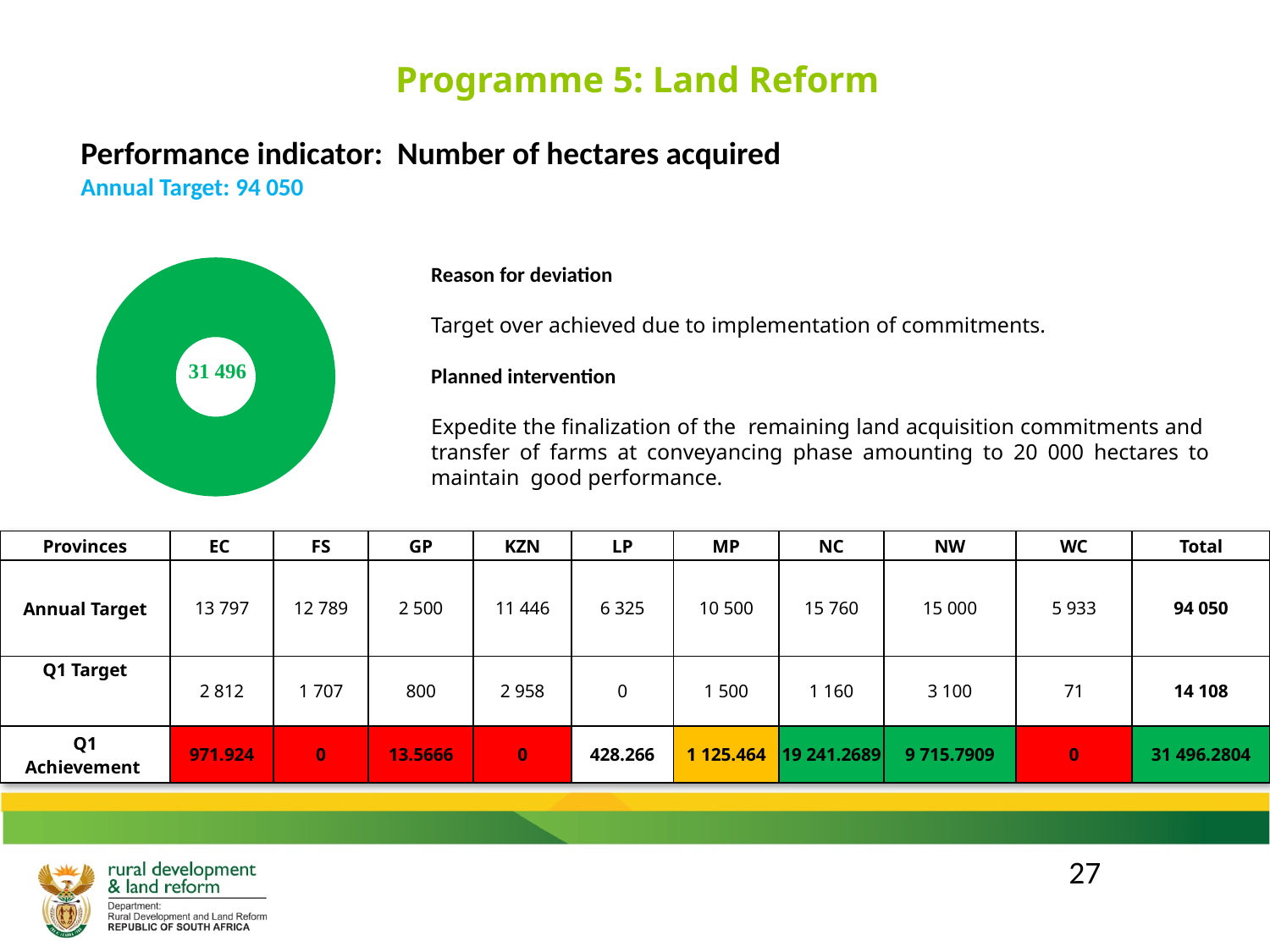
What kind of chart is shown on the left of the slide? Doughnut chart Is the value shown in the doughnut chart greater or less than 30 000? greater How many slices does the doughnut chart show? 1 What value is printed in the centre of the doughnut chart? 31 496 What colour is the doughnut chart's ring? Green